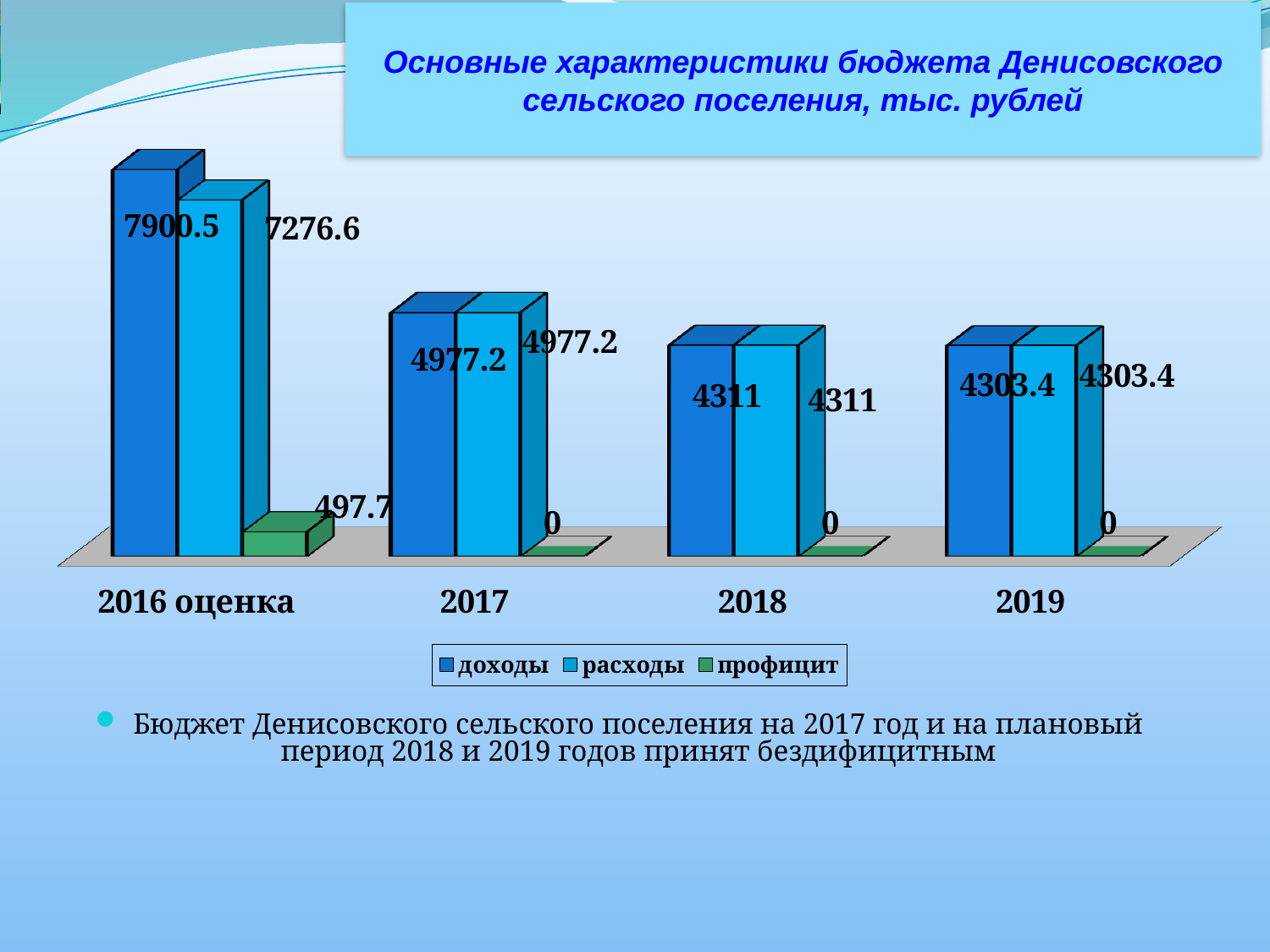
Which category has the lowest value of расходы? 2019 Which is larger: расходы for 2016 оценка or расходы for 2017? расходы for 2016 оценка What is the value of доходы for 2016 оценка? 7900.5 What is the value of профицит for 2017? 0 What is the value of расходы for 2019? 4303.4 How many series does the legend list? 3 What is the value of расходы for 2016 оценка? 7276.6 What is the value of доходы for 2018? 4311 Which category has the highest value of доходы? 2016 оценка What is the value of профицит for 2016 оценка? 497.7 What is the difference between доходы for 2017 and доходы for 2018? 666.2 What kind of chart is shown on the slide? bar chart